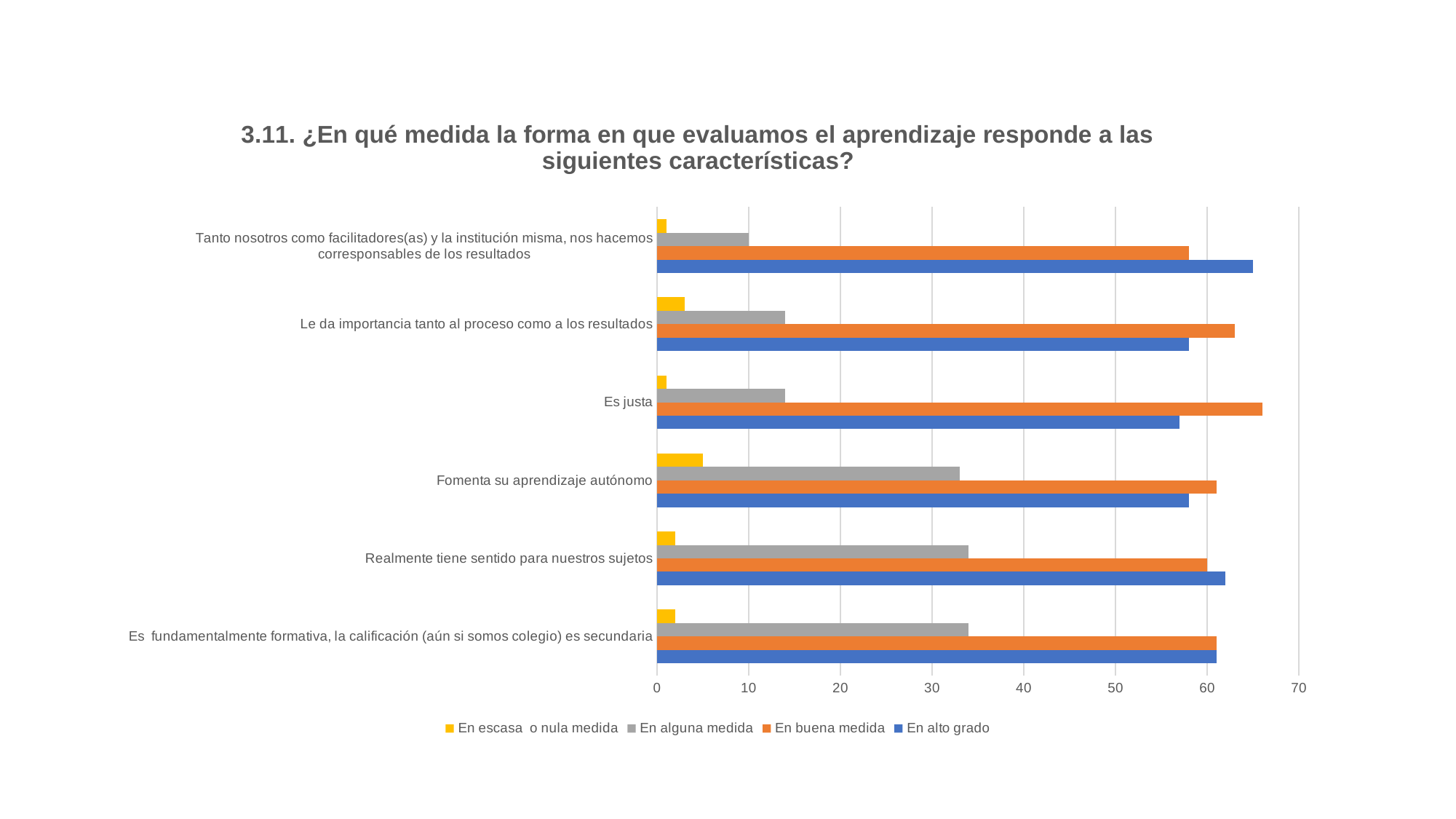
Which category has the highest 'En escasa o nula medida' value? Fomenta su aprendizaje autónomo Is the 'En alguna medida' value for 'Fomenta su aprendizaje autónomo' greater or less than 30? greater How many series does the legend list? 4 Is the 'En alto grado' value for 'Es justa' greater or less than 60? less Is the 'En alguna medida' value for 'Tanto nosotros como facilitadores(as) y la institución misma, nos hacemos corresponsables de los resultados' greater or less than 20? less What colour represents the 'En alto grado' series in the legend? blue For 'Es justa', which is larger: 'En buena medida' or 'En alto grado'? En buena medida Which category has the lowest 'En alguna medida' value? Tanto nosotros como facilitadores(as) y la institución misma, nos hacemos corresponsables de los resultados For 'Tanto nosotros como facilitadores(as) y la institución misma, nos hacemos corresponsables de los resultados', which is larger: 'En alto grado' or 'En buena medida'? En alto grado How many categories (characteristics) are plotted on the chart? 6 What kind of chart is shown on the slide? bar chart